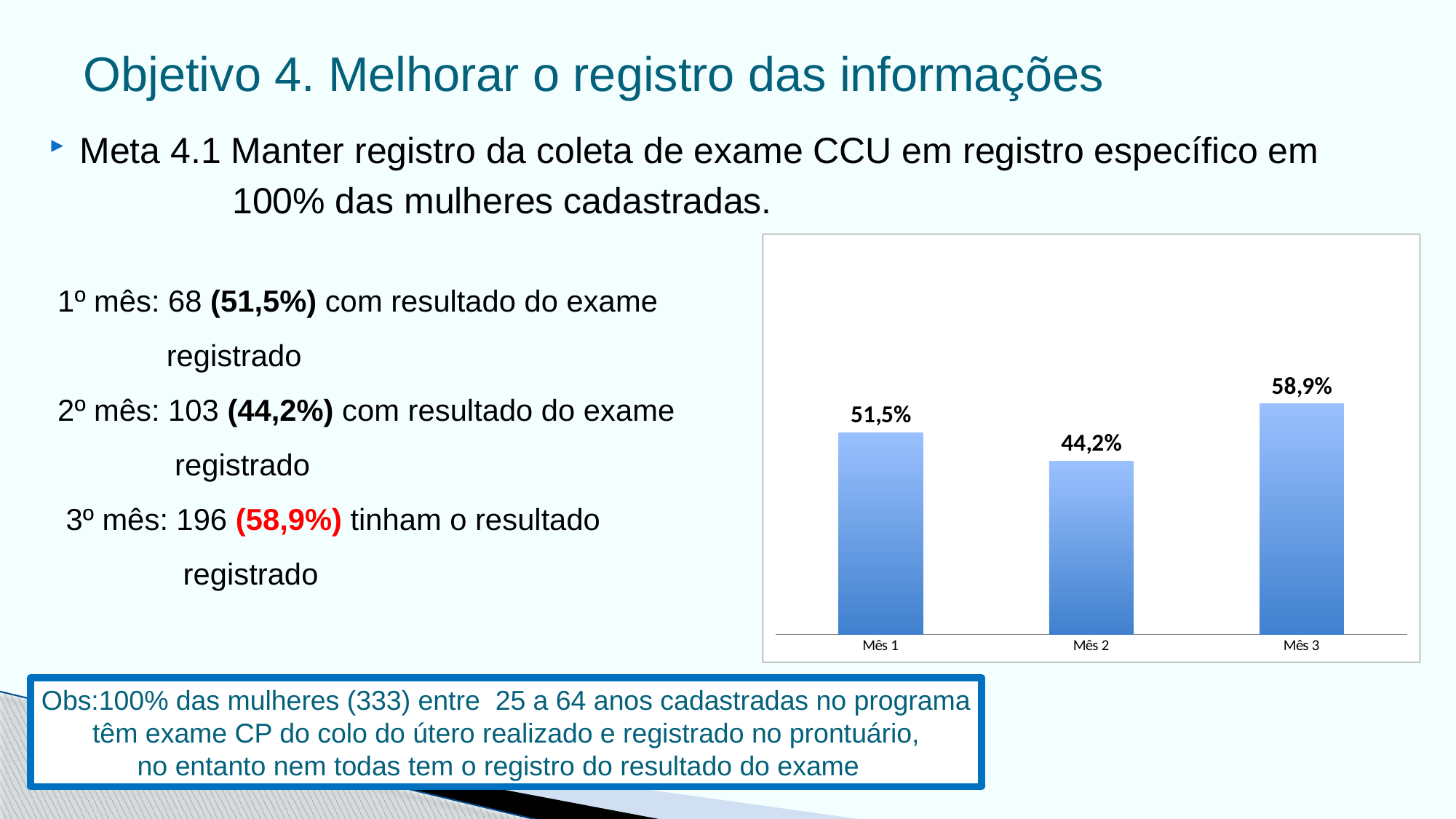
What kind of chart is shown on the slide? Bar chart What colour are the bars in the chart? Blue Which month has the highest value? Mês 3 Does the value rise or fall from Mês 1 to Mês 2? Fall What is the difference between the values for Mês 3 and Mês 2? 14,7% Which month has the lowest value? Mês 2 How many categories are shown on the x axis of the chart? 3 What is the difference between the values for Mês 1 and Mês 2? 7,3% Which is larger, the value for Mês 1 or the value for Mês 3? Mês 3 What is the value for Mês 2? 44,2% What is the value for Mês 1? 51,5% What is the value for Mês 3? 58,9%